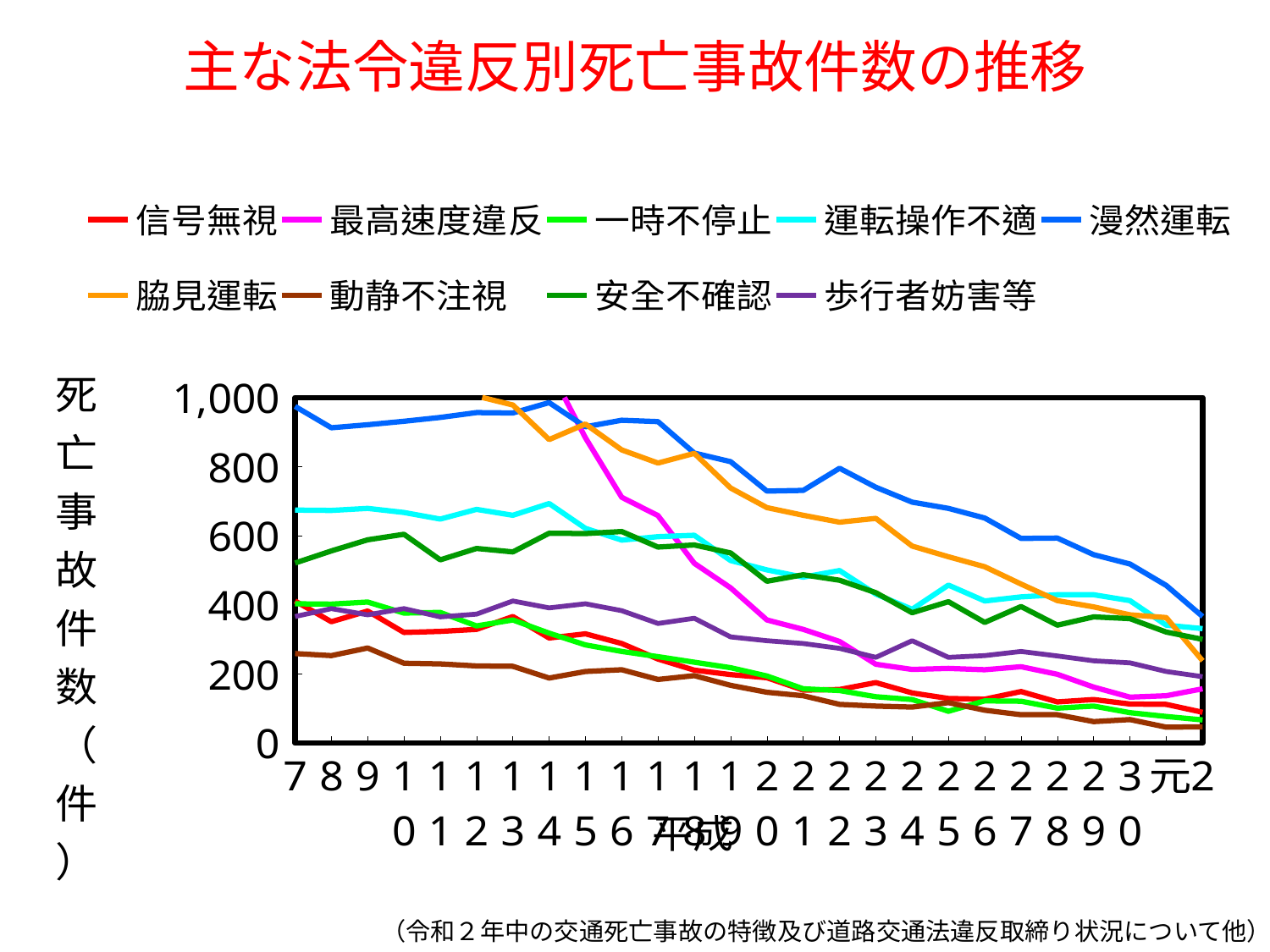
What is the title of the chart? 主な法令違反別死亡事故件数の推移 Is the value for 動静不注視 at 平成7 greater or less than 200? greater Is the value for 最高速度違反 at 令和2 greater or less than 200? less Is the value for 漫然運転 at 令和2 greater or less than 400? less At 平成7, which is larger: 漫然運転 or 動静不注視? 漫然運転 Does the 漫然運転 series generally rise or fall from 平成7 to 令和2? fall Which series is drawn in magenta (pink)? 最高速度違反 What kind of chart is shown on the slide? line chart Does the 最高速度違反 series generally rise or fall from 平成15 to 令和2? fall How many series does the legend list? 9